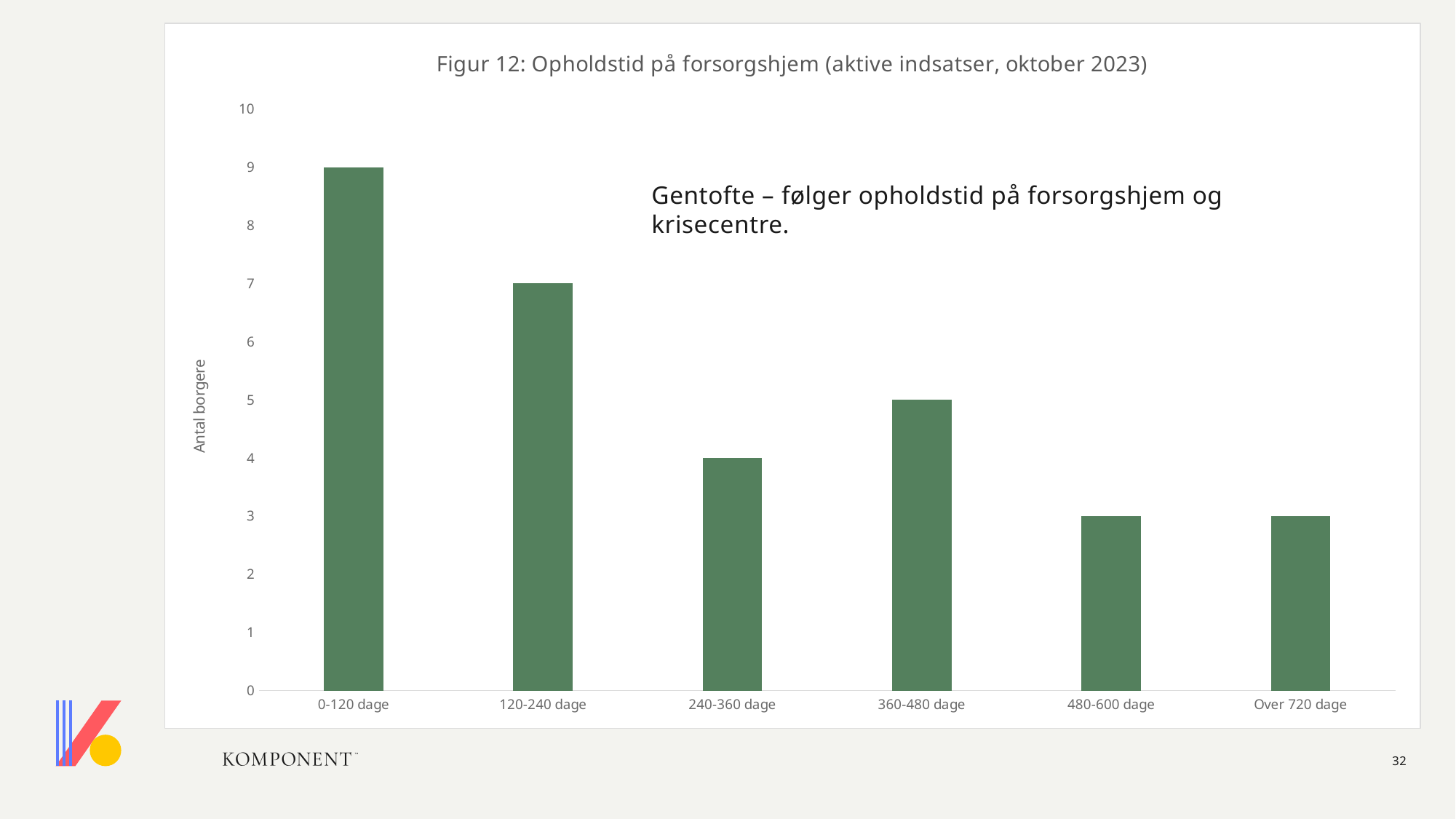
Which is larger, the value for 240-360 dage or the value for 360-480 dage? 360-480 dage What is the value for 240-360 dage? 4 What is the value for 360-480 dage? 5 What is the difference between the values for 0-120 dage and 120-240 dage? 2 What is the value for 480-600 dage? 3 Is the value for Over 720 dage greater or less than 5? less How many categories are shown on the x axis? 6 What is the value for 120-240 dage? 7 What is the value for 0-120 dage? 9 What is the label of the y axis? Antal borgere What kind of chart is shown on the slide? bar chart Which category has the highest value? 0-120 dage